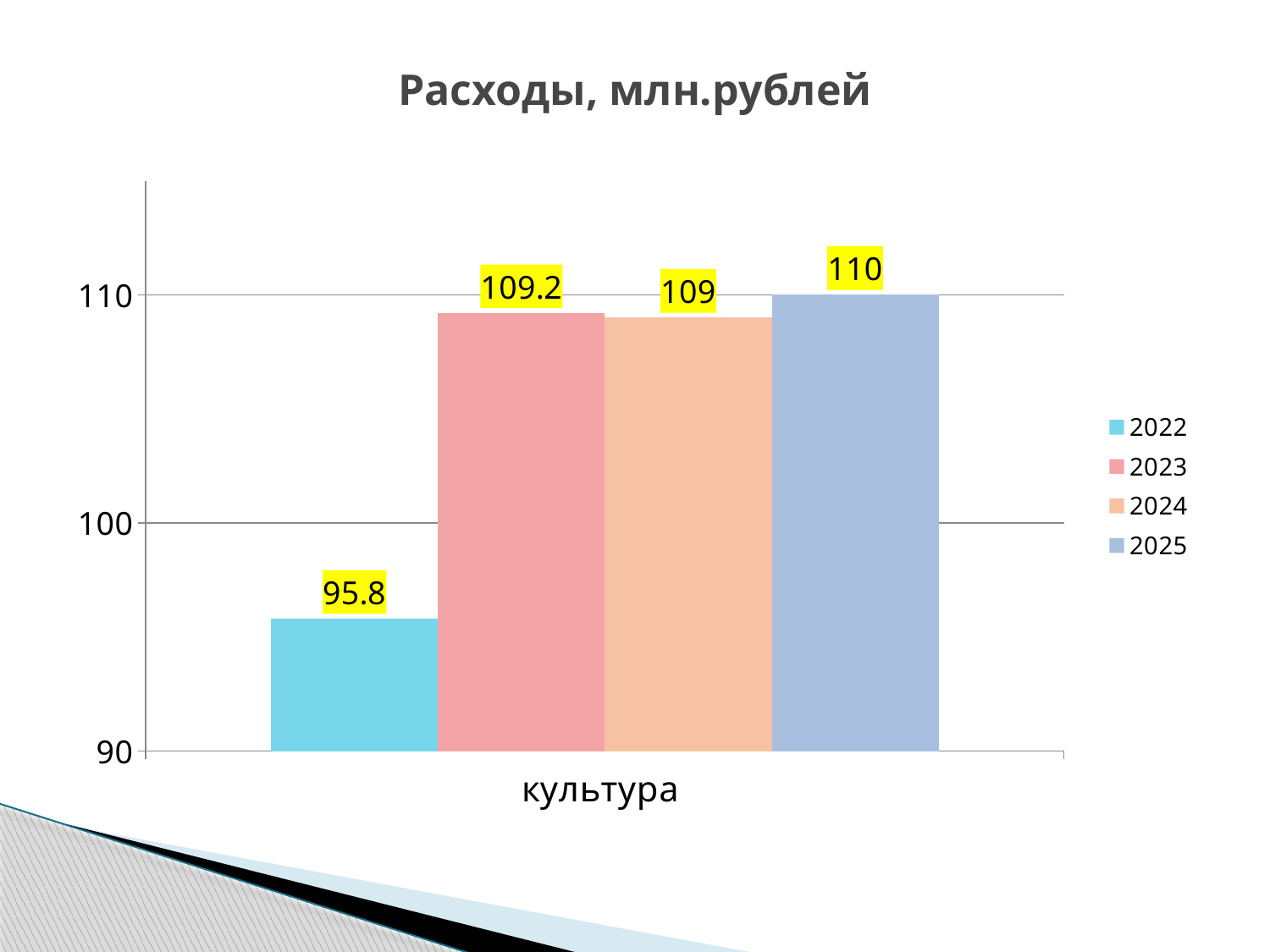
What is the value for 2023 in the культура category? 109.2 What is the difference between the values for 2023 and 2024? 0.2 How many series does the legend list? 4 Which year has the highest value? 2025 What is the value for 2025 in the культура category? 110 What kind of chart is shown on the slide? bar chart What is the value for 2022 in the культура category? 95.8 Which year has the lowest value? 2022 Is the value for 2022 greater or less than 100? less What is the value for 2024 in the культура category? 109 What is the difference between the values for 2025 and 2022? 14.2 Which is larger, the value for 2022 or the value for 2024? 2024